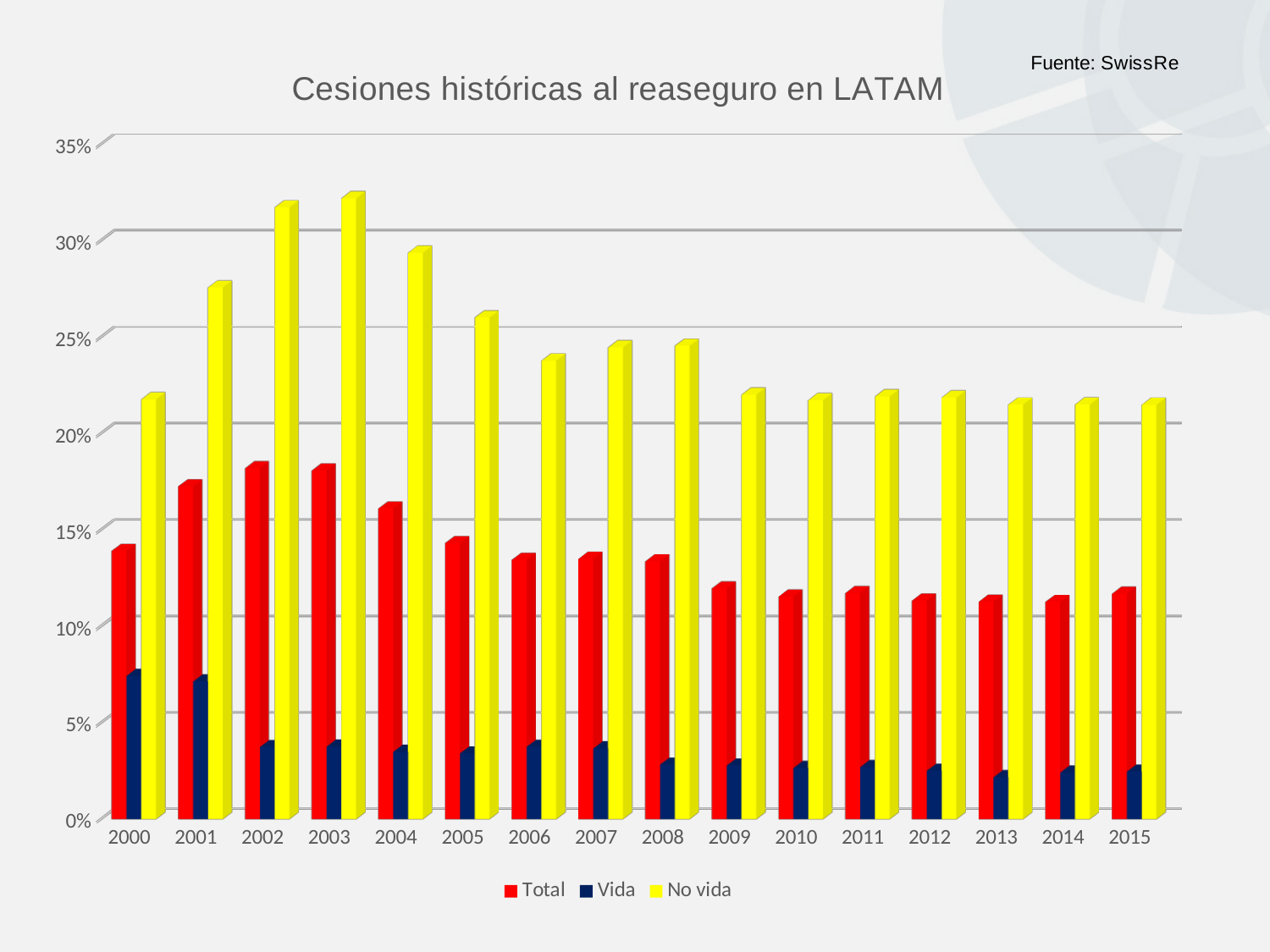
Is the value for Vida in 2000 greater or less than 5%? greater What kind of chart is shown on the slide? Bar chart Which is larger, the No vida value for 2001 or for 2004? 2004 Do the Total values rise or fall from 2003 to 2013? fall Is the value for Vida in 2010 greater or less than 5%? less Is the value for No vida in 2002 greater or less than 30%? greater Which is larger, the Total value for 2001 or for 2009? 2001 What is the title of the chart? Cesiones históricas al reaseguro en LATAM How many years are shown on the x axis? 16 How many series does the legend list? 3 Which year has the highest value for No vida? 2003